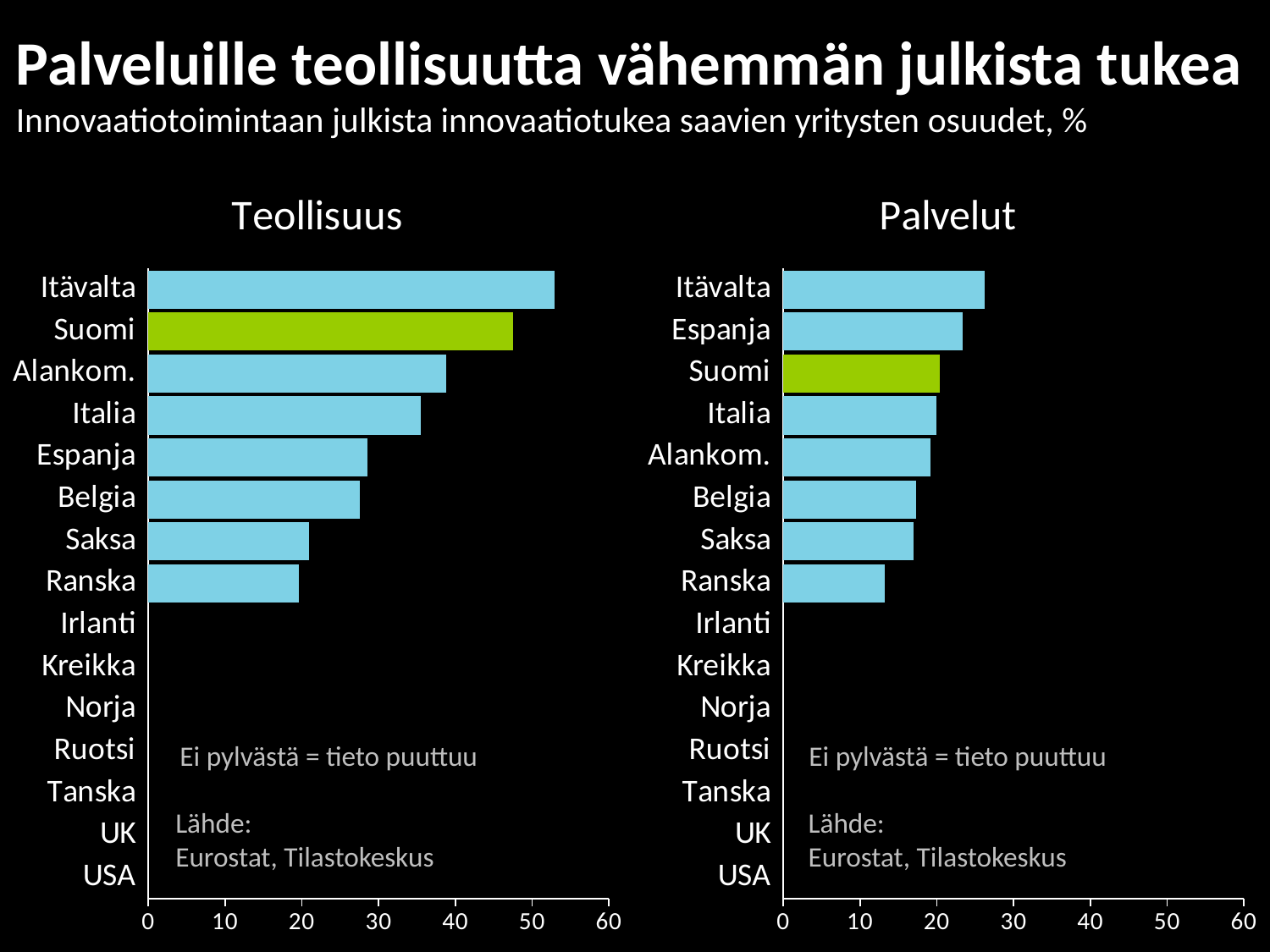
In the Teollisuus chart, which country with a bar has the lowest value? Ranska In the Palvelut chart, is the value for Itävalta greater or less than 20? greater In the Palvelut chart, which country with a bar has the lowest value? Ranska Is the value for Suomi larger in the Teollisuus chart or in the Palvelut chart? Teollisuus In the Teollisuus chart, is the value for Itävalta greater or less than 50? greater How many countries are listed on the y axis of the Palvelut chart? 15 In the Palvelut chart, is the value for Ranska greater or less than 20? less In the Teollisuus chart, which country's bar is shown in green? Suomi In the Teollisuus chart, which country has the highest value? Itävalta What kind of chart is the Teollisuus chart on the left? bar chart In the Palvelut chart, which country has the highest value? Itävalta